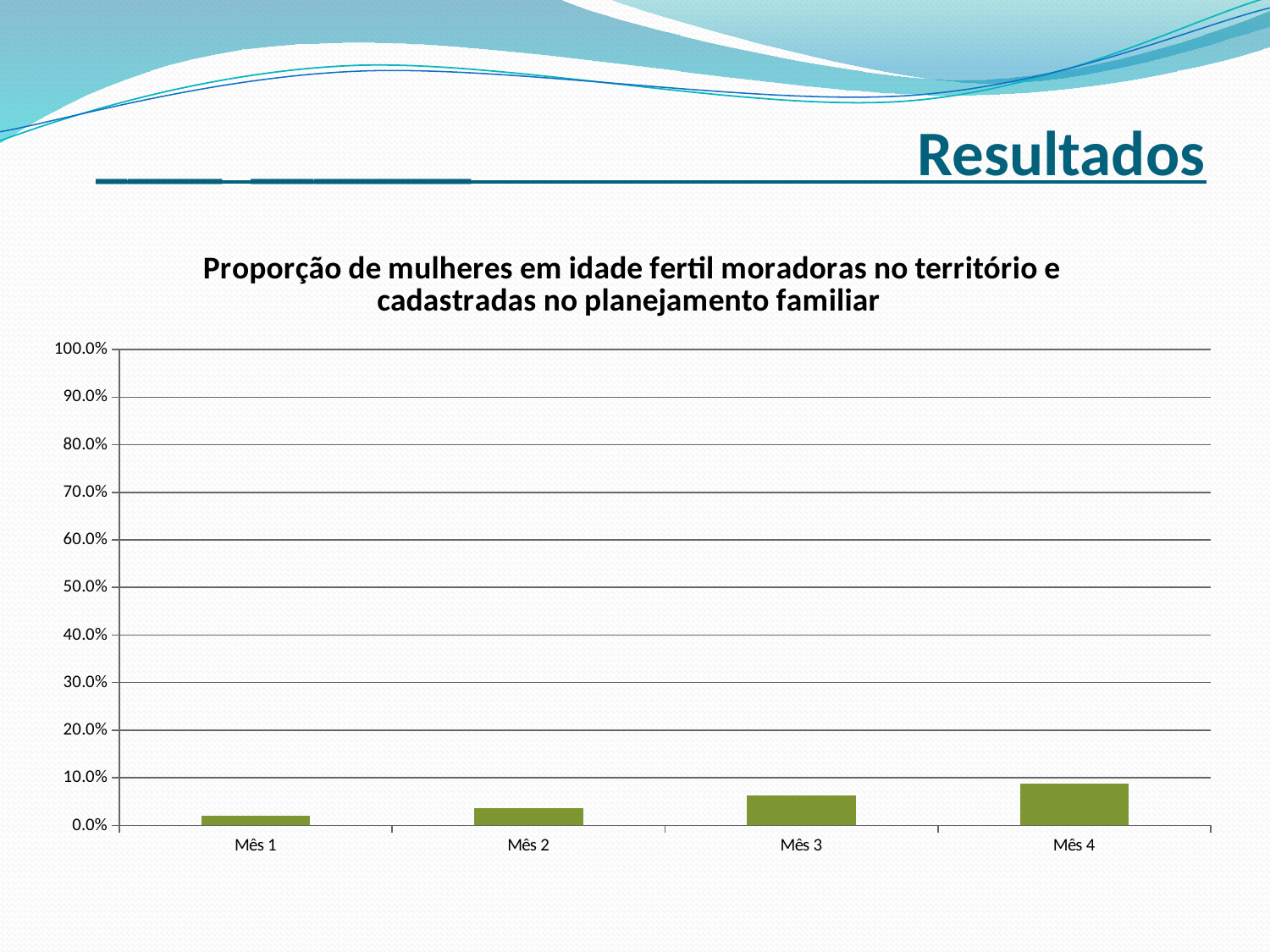
What kind of chart is shown on the slide? bar chart What is the title of the chart? Proporção de mulheres em idade fertil moradoras no território e cadastradas no planejamento familiar Which month has the highest bar in the chart? Mês 4 Which month has the lowest bar in the chart? Mês 1 Is the value for Mês 1 greater or less than 10.0%? less How many categories (months) are shown on the x axis of the chart? 4 Is the value for Mês 4 greater or less than 10.0%? less What is the highest value shown on the y axis of the chart? 100.0% Which is larger, the value for Mês 3 or the value for Mês 2? Mês 3 Which is larger, the value for Mês 1 or the value for Mês 4? Mês 4 Is the value for Mês 3 greater or less than 20.0%? less Do the values rise or fall from Mês 1 to Mês 4? rise